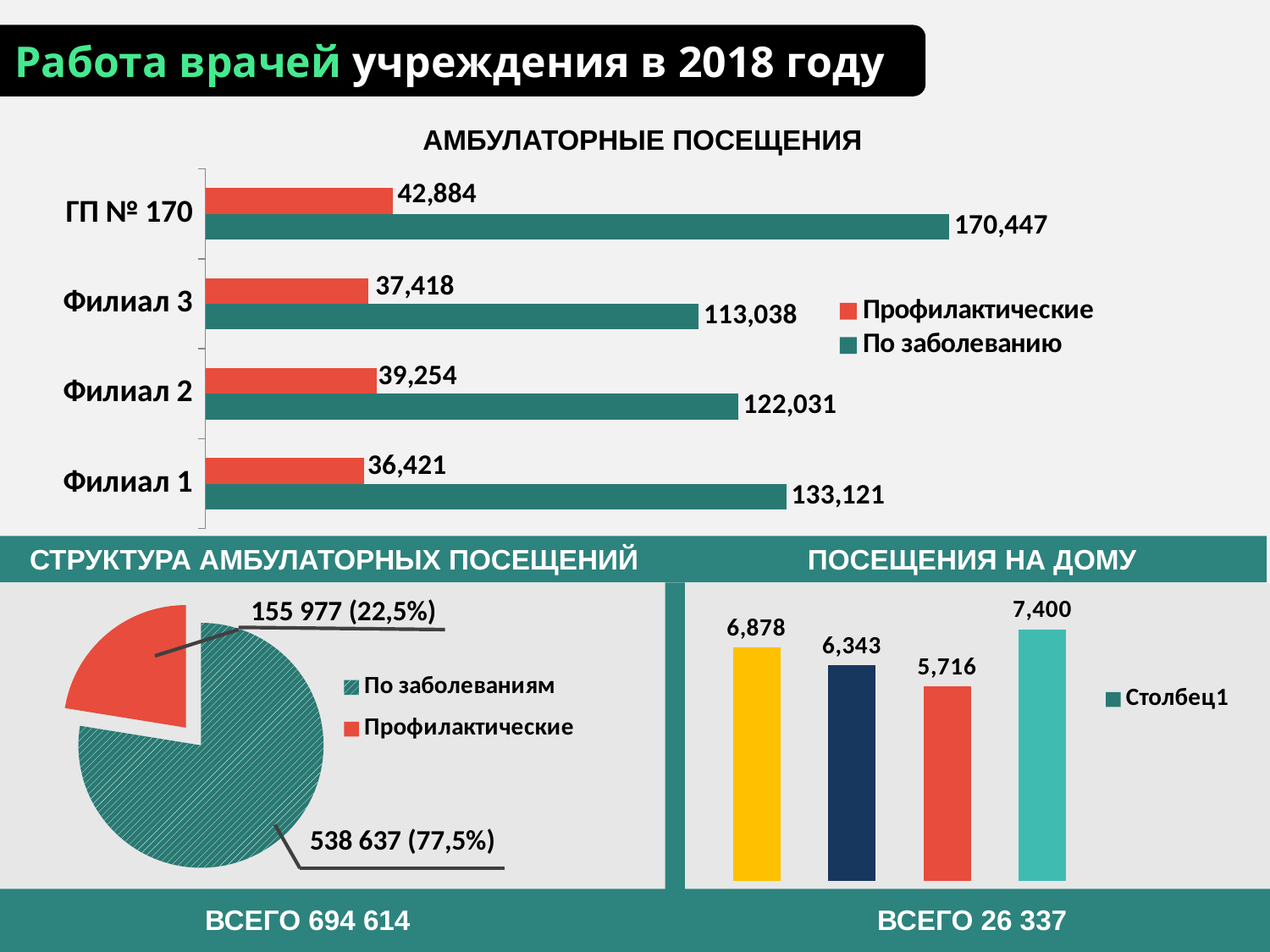
In the 'АМБУЛАТОРНЫЕ ПОСЕЩЕНИЯ' chart, what is the 'По заболеванию' value for ГП № 170? 170,447 In the 'АМБУЛАТОРНЫЕ ПОСЕЩЕНИЯ' chart, which category has the lowest 'Профилактические' value? Филиал 1 In the 'ПОСЕЩЕНИЯ НА ДОМУ' chart, what is the highest value shown? 7,400 In the 'АМБУЛАТОРНЫЕ ПОСЕЩЕНИЯ' chart, which category has the highest 'По заболеванию' value? ГП № 170 How many categories are shown in the 'АМБУЛАТОРНЫЕ ПОСЕЩЕНИЯ' chart? 4 What kind of chart is 'СТРУКТУРА АМБУЛАТОРНЫХ ПОСЕЩЕНИЙ'? Pie chart How many bars are shown in the 'ПОСЕЩЕНИЯ НА ДОМУ' chart? 4 In the 'АМБУЛАТОРНЫЕ ПОСЕЩЕНИЯ' chart, what is the 'Профилактические' value for Филиал 1? 36,421 In the 'СТРУКТУРА АМБУЛАТОРНЫХ ПОСЕЩЕНИЙ' pie chart, what share do 'Профилактические' visits make up? 22,5% In the 'АМБУЛАТОРНЫЕ ПОСЕЩЕНИЯ' chart, what is the difference between the 'По заболеванию' values for Филиал 1 and Филиал 2? 11,090 How many series does the legend of the 'АМБУЛАТОРНЫЕ ПОСЕЩЕНИЯ' chart list? 2 In the 'АМБУЛАТОРНЫЕ ПОСЕЩЕНИЯ' chart, which is larger: the 'Профилактические' value for Филиал 3 or for Филиал 2? Филиал 2